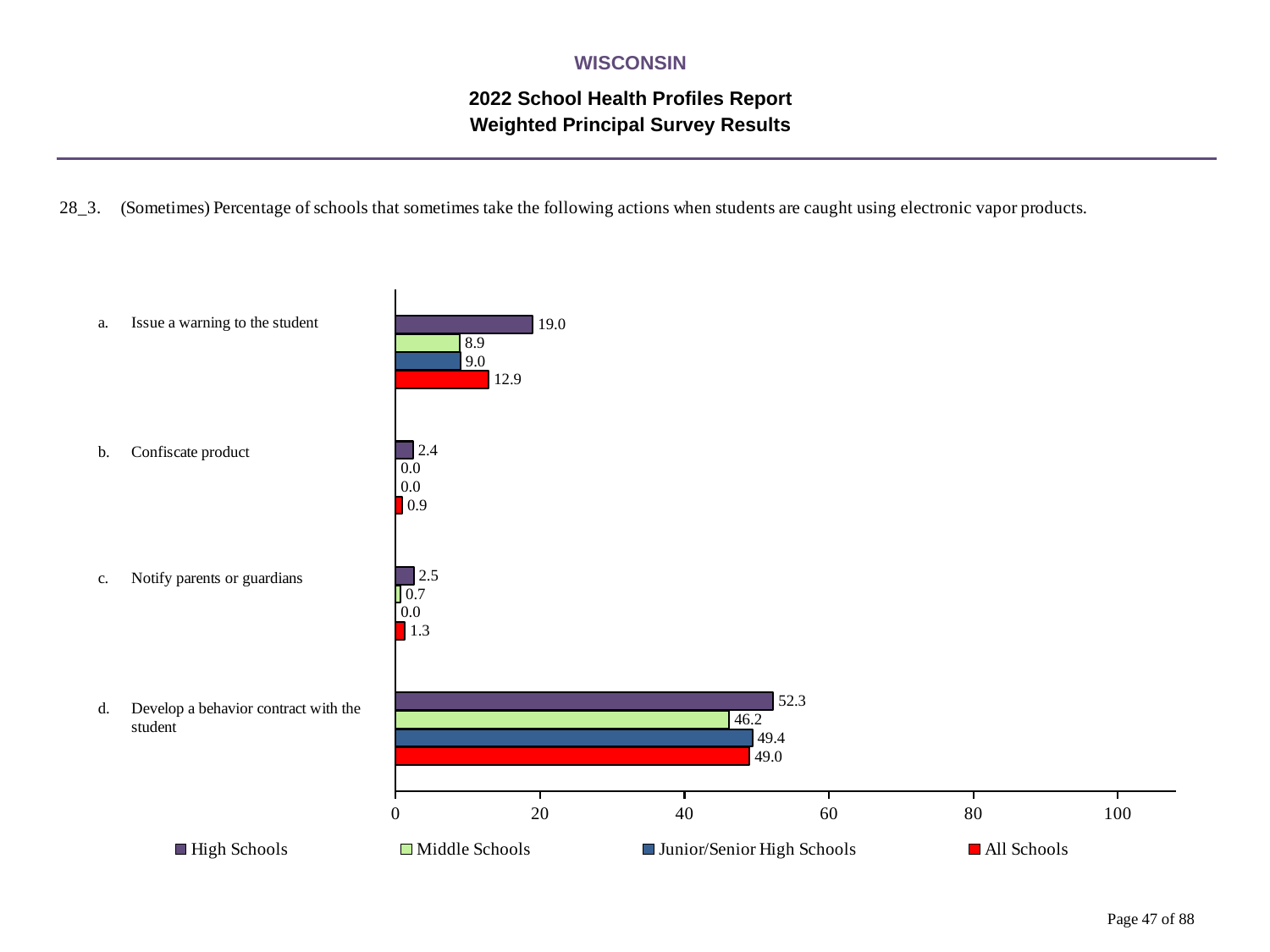
What is the Middle Schools value for 'Notify parents or guardians'? 0.7 Is the Junior/Senior High Schools value for 'Develop a behavior contract with the student' greater or less than 40? greater How many actions (categories) are shown on the chart? 4 What is the High Schools value for 'Issue a warning to the student'? 19.0 What is the Junior/Senior High Schools value for 'Confiscate product'? 0.0 Which action has the lowest All Schools value? Confiscate product How many series does the legend list? 4 Which action has the highest High Schools value? Develop a behavior contract with the student What is the All Schools value for 'Develop a behavior contract with the student'? 49.0 For 'Issue a warning to the student', which is larger: the High Schools value or the All Schools value? High Schools What is the difference between the High Schools and Middle Schools values for 'Develop a behavior contract with the student'? 6.1 What kind of chart is shown on the slide? Bar chart